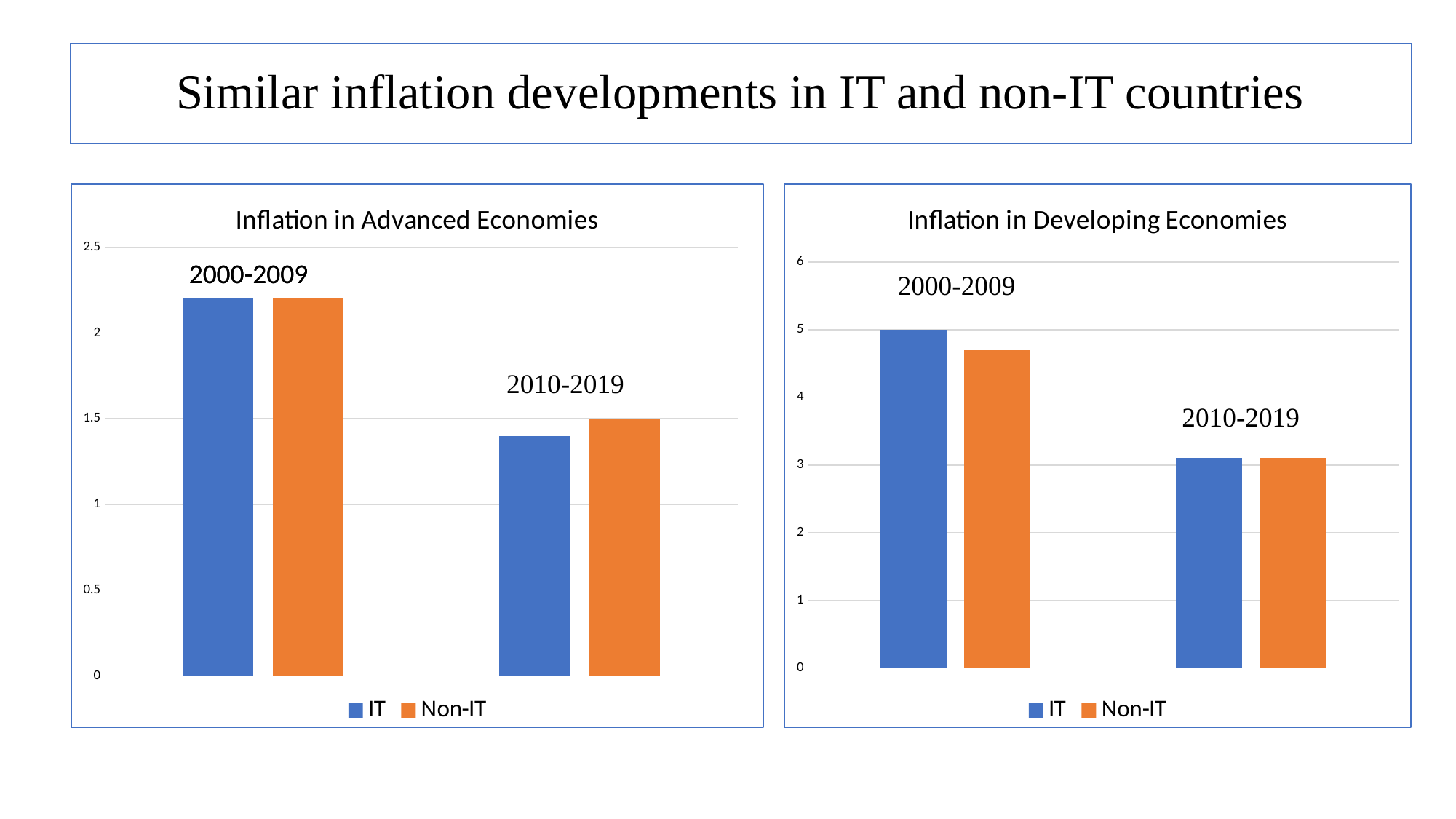
In "Inflation in Advanced Economies", which is larger in 2010-2019, IT or Non-IT? Non-IT In "Inflation in Developing Economies", what is the value for IT in 2000-2009? 5 In "Inflation in Developing Economies", is the value for Non-IT in 2000-2009 greater or less than 4? greater In "Inflation in Developing Economies", which is larger in 2000-2009, IT or Non-IT? IT In "Inflation in Advanced Economies", is the value for IT in 2000-2009 greater or less than 2? greater What kind of chart is "Inflation in Advanced Economies"? bar chart What colour represents the Non-IT series in the charts? orange In "Inflation in Developing Economies", is the value for IT in 2010-2019 greater or less than 4? less How many series does the legend of "Inflation in Developing Economies" list? 2 In "Inflation in Developing Economies", do the IT values rise or fall from 2000-2009 to 2010-2019? fall In "Inflation in Advanced Economies", how many periods are shown on the x axis? 2